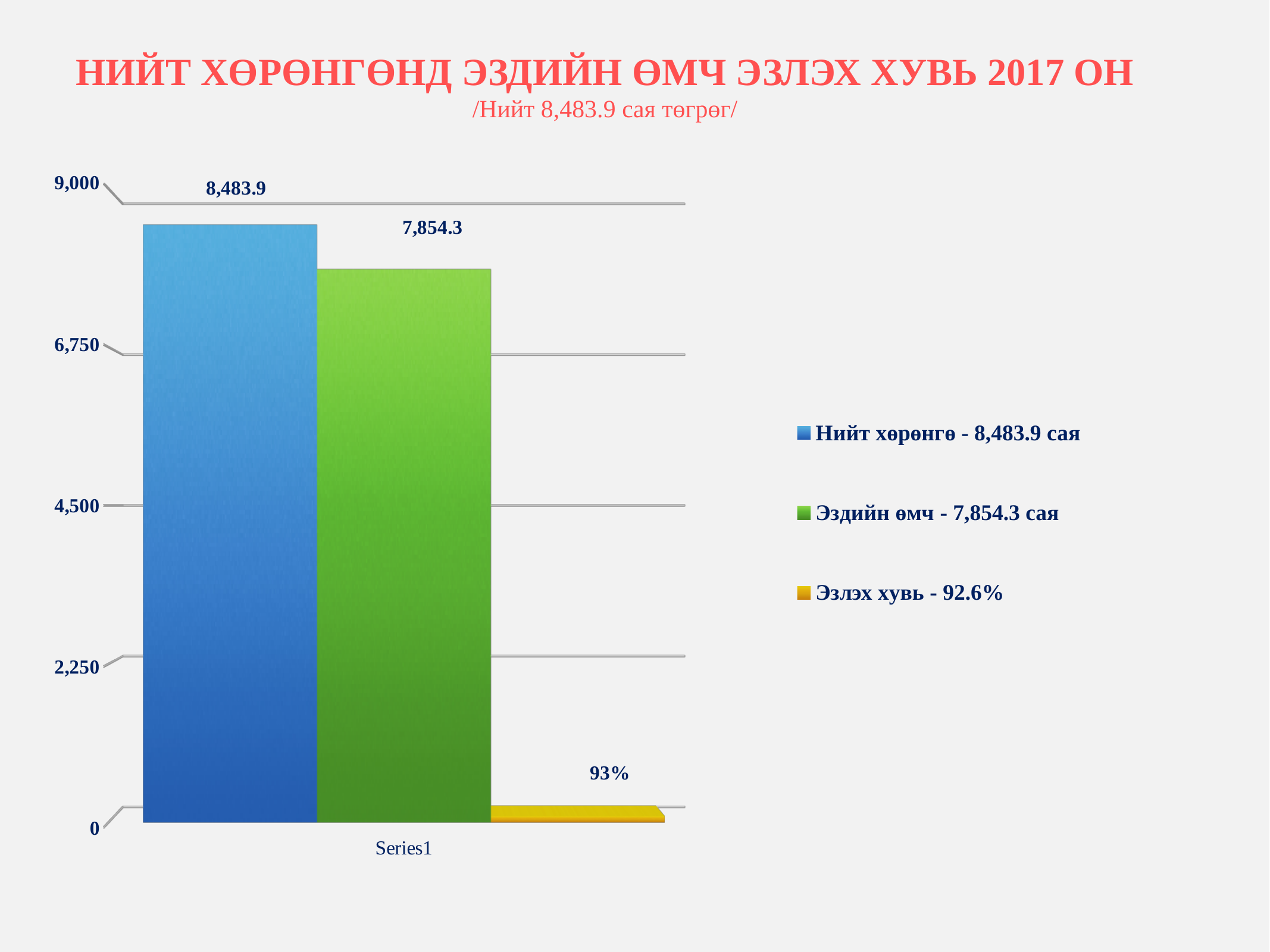
What percentage is given for Эзлэх хувь in the legend? 92.6% What is the data label on the yellow bar for Эзлэх хувь? 93% What is the difference between the Нийт хөрөнгө value (8,483.9) and the Эздийн өмч value (7,854.3)? 629.6 Which is larger, the bar for Нийт хөрөнгө or the bar for Эздийн өмч? Нийт хөрөнгө Is the value for Эздийн өмч greater or less than 6,750? greater Which series has the shortest bar? Эзлэх хувь What kind of chart is shown on the slide? bar chart How many series does the legend list? 3 What is the category label shown on the x axis? Series1 What is the data label on the bar for Эздийн өмч? 7,854.3 What is the data label on the bar for Нийт хөрөнгө? 8,483.9 Which series has the tallest bar? Нийт хөрөнгө